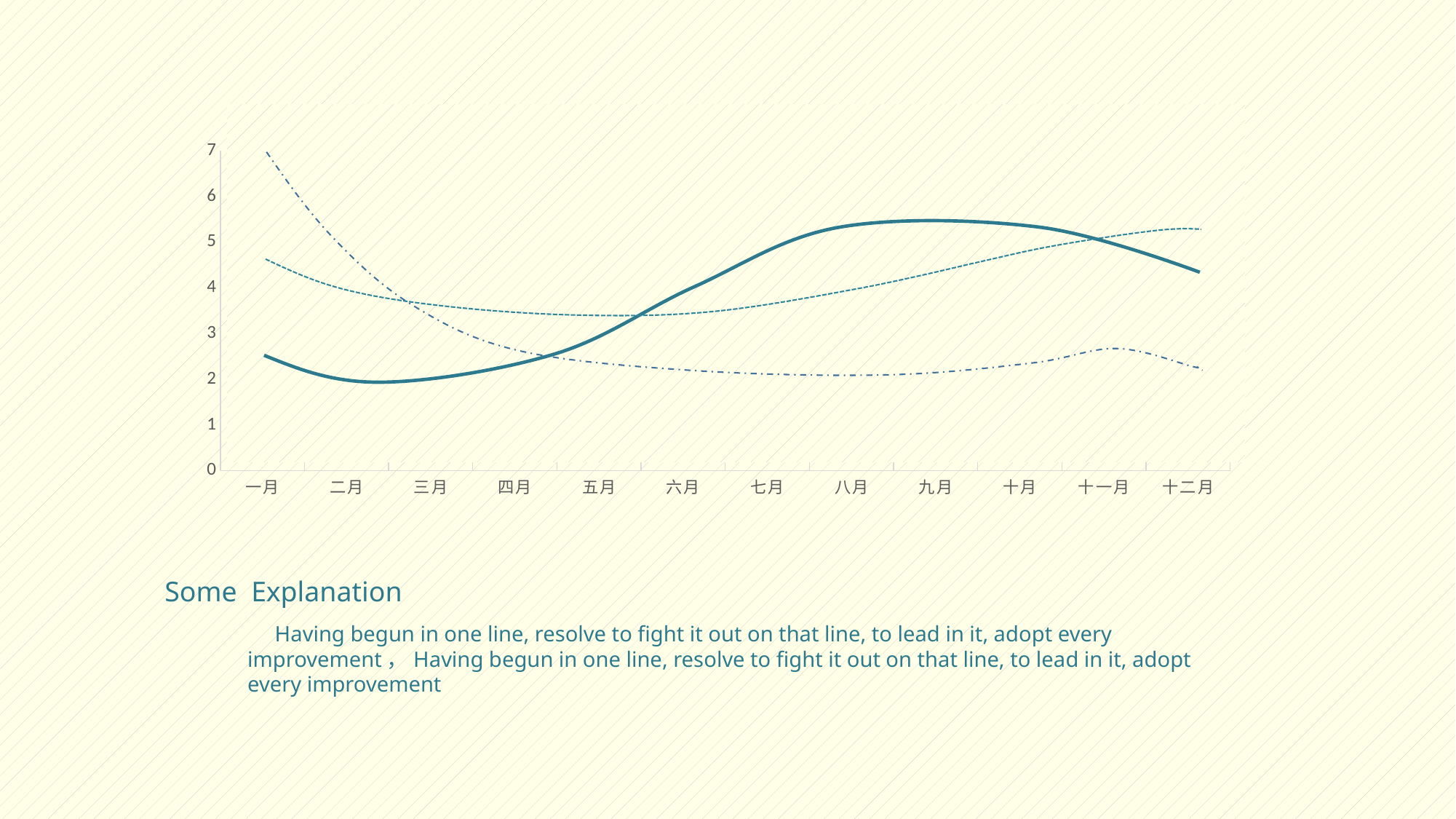
Is the value of the dash-dot line at 一月 greater or less than 6? greater What kind of chart is shown on the slide? line chart Is the value of the dash-dot line at 七月 greater or less than 3? less At 一月, which line has the higher value, the thick solid line or the dash-dot line? the dash-dot line How many lines are plotted on the chart? 3 Does the dash-dot line rise or fall from 一月 to 七月? fall At 九月, which line has the higher value, the thick solid line or the dash-dot line? the thick solid line Is the value of the thick solid line at 九月 greater or less than 5? greater How many months are shown on the x axis of the chart? 12 In which month does the dash-dot line reach its highest value? 一月